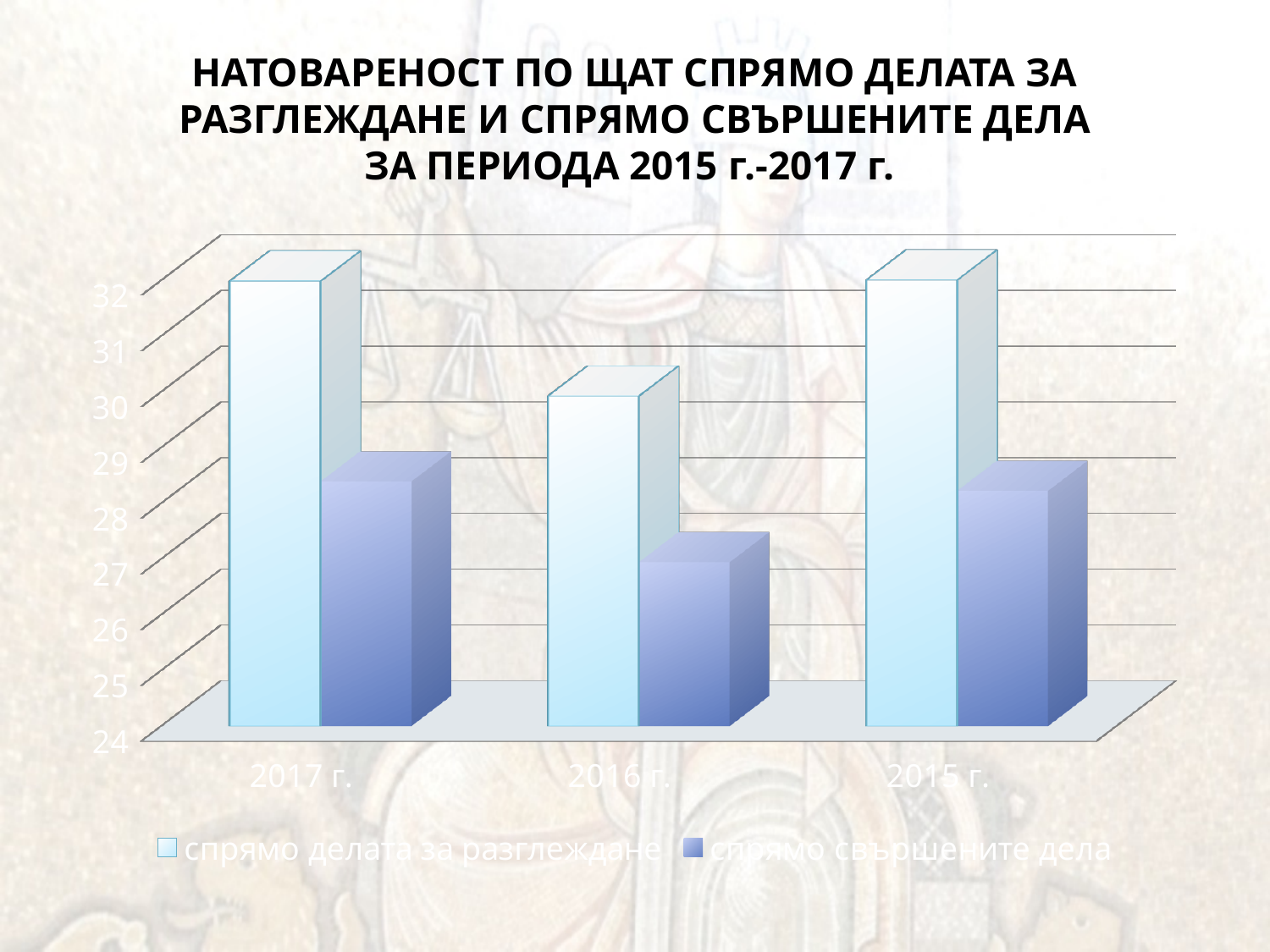
Which series is shown with the darker blue bars in the chart? спрямо свършените дела How many series does the chart legend list? 2 How many years (categories) are shown on the x axis of the chart? 3 Is the value for 'спрямо делата за разглеждане' in 2017 г. greater or less than 31? greater Which year has the lowest value for the series 'спрямо свършените дела'? 2016 г. For the series 'спрямо делата за разглеждане', which year has the larger value: 2016 г. or 2015 г.? 2015 г. Is the value for 'спрямо свършените дела' in 2016 г. greater or less than 28? less In 2017 г., which series has the larger value: 'спрямо делата за разглеждане' or 'спрямо свършените дела'? спрямо делата за разглеждане Is the value for 'спрямо делата за разглеждане' in 2016 г. greater or less than 31? less What kind of chart is shown on the slide? bar chart Which year has the lowest value for the series 'спрямо делата за разглеждане'? 2016 г.